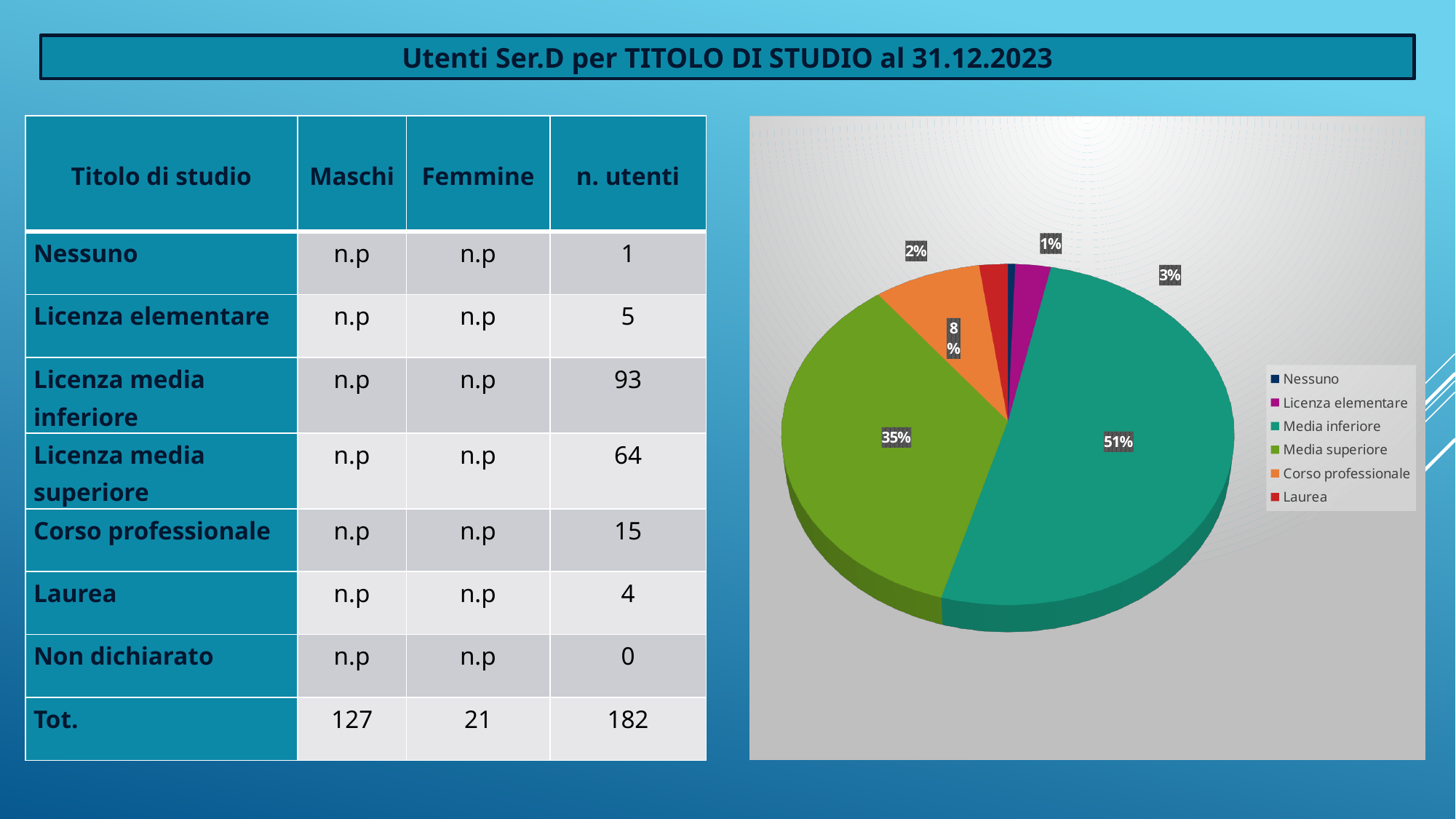
What percentage of the pie chart is labelled for Corso professionale? 8% What percentage of the pie chart is labelled for Media inferiore? 51% Which category has the largest slice in the pie chart? Media inferiore Which category has the smallest slice in the pie chart? Nessuno In the pie chart, what is the difference in percentage points between Media inferiore and Media superiore? 16 What kind of chart is shown on the slide? pie chart What percentage of the pie chart is labelled for Laurea? 2% How many entries does the pie chart's legend list? 6 What percentage of the pie chart is labelled for Licenza elementare? 3% What percentage of the pie chart is labelled for Nessuno? 1% In the pie chart, which slice is larger: Corso professionale or Laurea? Corso professionale What percentage of the pie chart is labelled for Media superiore? 35%